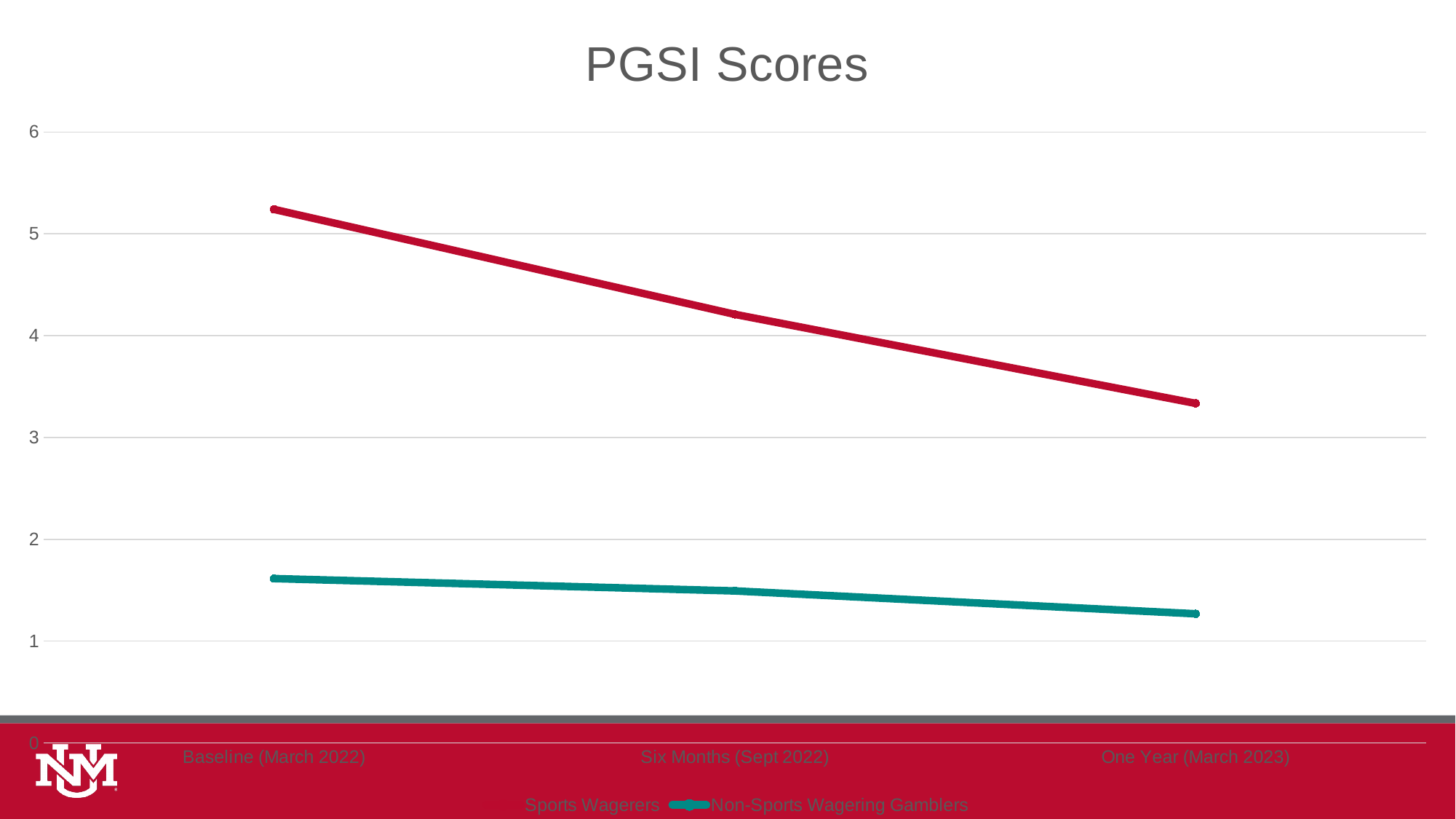
What is the title of the chart? PGSI Scores At Baseline (March 2022), which series has the higher PGSI score, Sports Wagerers or Non-Sports Wagering Gamblers? Sports Wagerers Do the PGSI scores for Sports Wagerers rise or fall from Baseline (March 2022) to One Year (March 2023)? fall What kind of chart is shown on the slide? line chart How many time points are plotted along the x axis? 3 Do the PGSI scores for Non-Sports Wagering Gamblers rise or fall across the three time points? fall Is the value for Non-Sports Wagering Gamblers at Baseline (March 2022) greater or less than 2? less Is the value for Non-Sports Wagering Gamblers at One Year (March 2023) greater or less than 1? greater Is the value for Sports Wagerers at Baseline (March 2022) greater or less than 4? greater How many series does the legend list? 2 Which series is drawn in red? Sports Wagerers